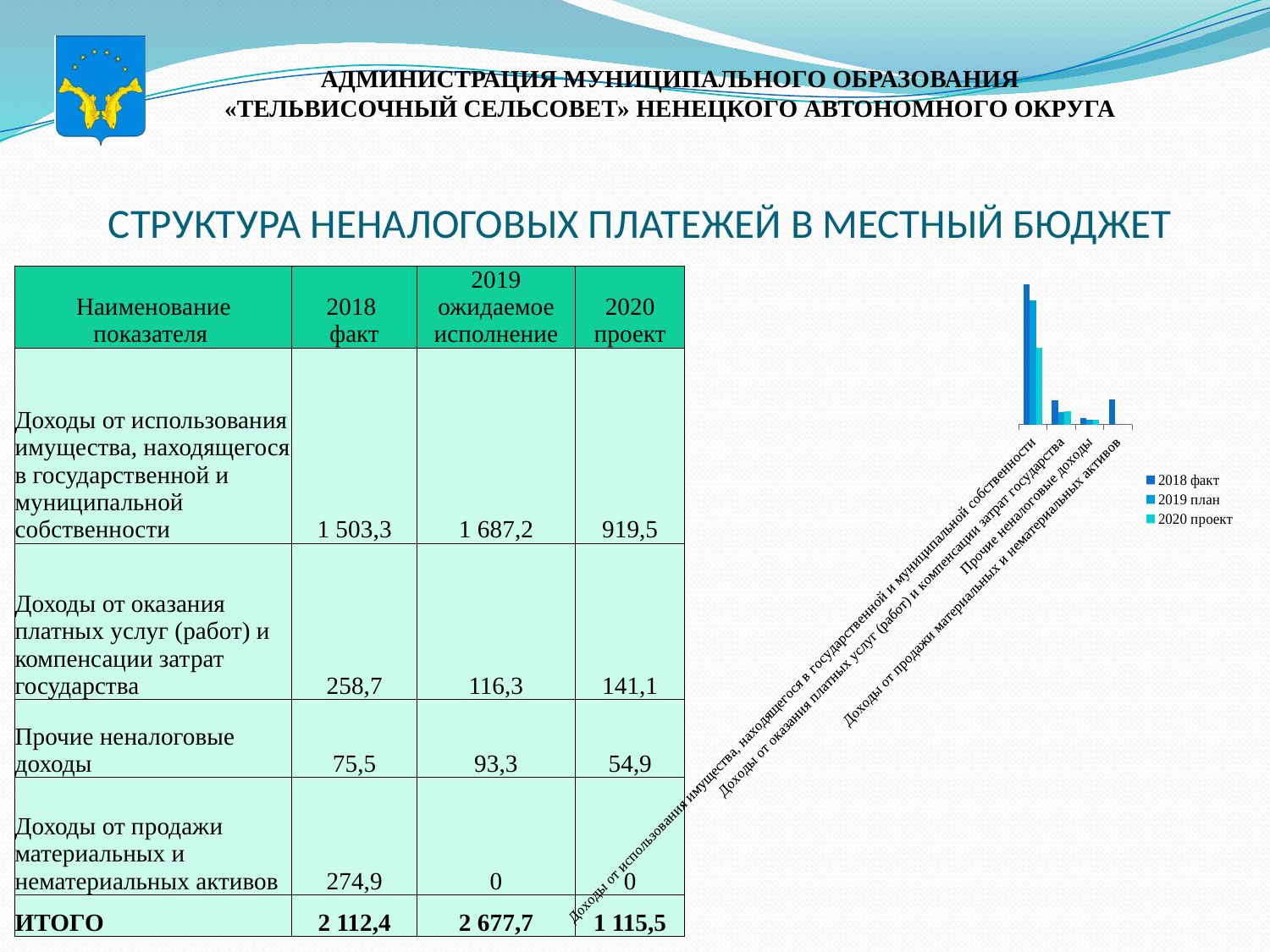
Which category has the tallest bars in the chart? Доходы от использования имущества, находящегося в государственной и муниципальной собственности For the category 'Доходы от использования имущества, находящегося в государственной и муниципальной собственности', which bar is taller: 2018 факт or 2020 проект? 2018 факт Which category shows a bar only for the 2018 факт series, with no visible bars for 2019 план and 2020 проект? Доходы от продажи материальных и нематериальных активов What are the three entries in the chart legend? 2018 факт, 2019 план, 2020 проект What kind of chart is shown on the slide? bar chart Which series has the tallest bar in the chart? 2018 факт For the category 'Доходы от оказания платных услуг (работ) и компенсации затрат государства', which bar is taller: 2018 факт or 2019 план? 2018 факт Which series is shown in the darkest blue colour in the chart? 2018 факт How many categories are shown on the chart's x axis? 4 How many series does the chart legend list? 3 Which is taller: the 2020 проект bar for 'Доходы от использования имущества...' or the 2020 проект bar for 'Прочие неналоговые доходы'? Доходы от использования имущества...